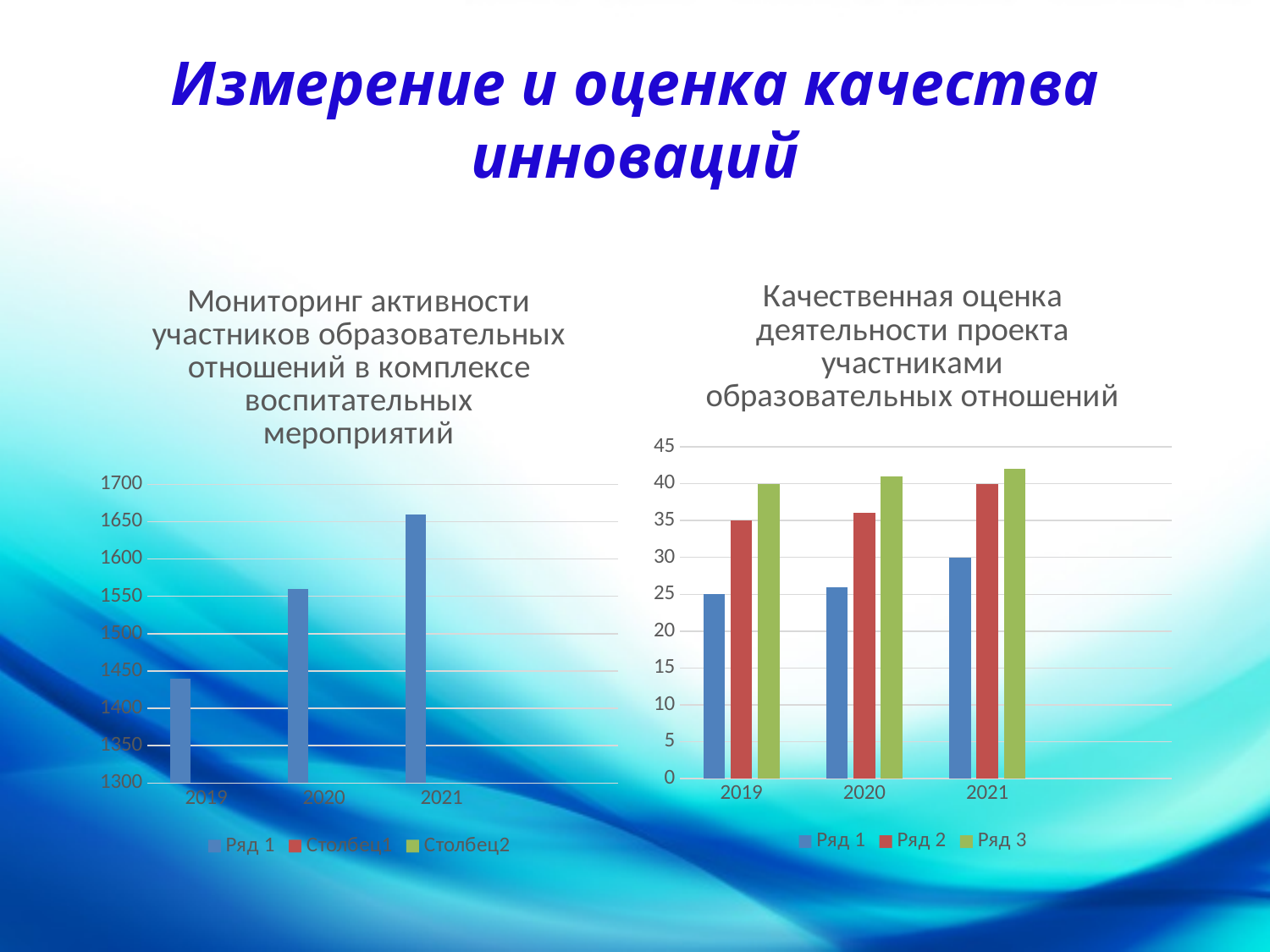
In the left chart (Мониторинг активности...), which year has the highest bar? 2021 In the right chart (Качественная оценка деятельности проекта...), which is larger: Ряд 2 in 2021 or Ряд 2 in 2019? Ряд 2 in 2021 How many years are shown on the x axis of the right chart (Качественная оценка деятельности проекта...)? 3 In the right chart (Качественная оценка деятельности проекта...), which series has the highest bar in 2019? Ряд 3 In the left chart (Мониторинг активности...), which year has the lowest bar? 2019 In the left chart (Мониторинг активности...), is the value for 2019 greater or less than 1450? less In the left chart (Мониторинг активности...), is the value for 2021 greater or less than 1600? greater In the left chart (Мониторинг активности...), do the values rise or fall from 2019 to 2021? rise What type of chart is the left chart titled "Мониторинг активности участников образовательных отношений в комплексе воспитательных мероприятий"? Bar chart In the right chart (Качественная оценка деятельности проекта...), is the value of Ряд 3 for 2021 greater or less than 40? greater How many series does the legend of the right chart (Качественная оценка деятельности проекта...) list? 3